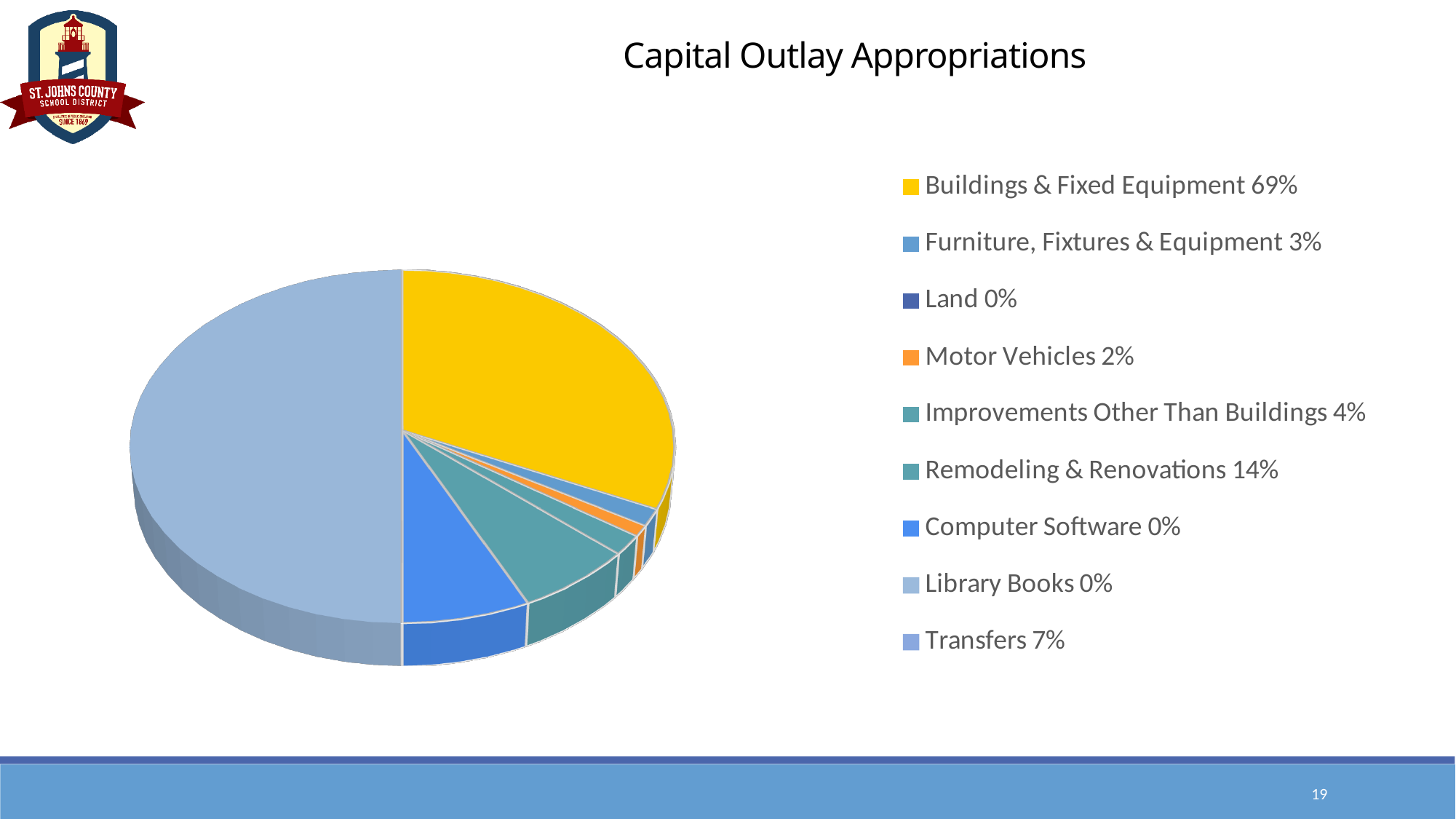
What percentage is shown for Improvements Other Than Buildings? 4% What percentage is shown for Motor Vehicles? 2% How many categories does the legend list? 9 What percentage is shown for Furniture, Fixtures & Equipment? 3% What percentage is shown for Buildings & Fixed Equipment? 69% What is the title of the chart? Capital Outlay Appropriations What kind of chart is shown on the slide? pie chart What is the difference between the Buildings & Fixed Equipment share and the Remodeling & Renovations share? 55% What percentage is shown for Transfers? 7% What percentage is shown for Remodeling & Renovations? 14% Which is larger, the share for Remodeling & Renovations or the share for Transfers? Remodeling & Renovations Which category has the largest share according to the legend? Buildings & Fixed Equipment